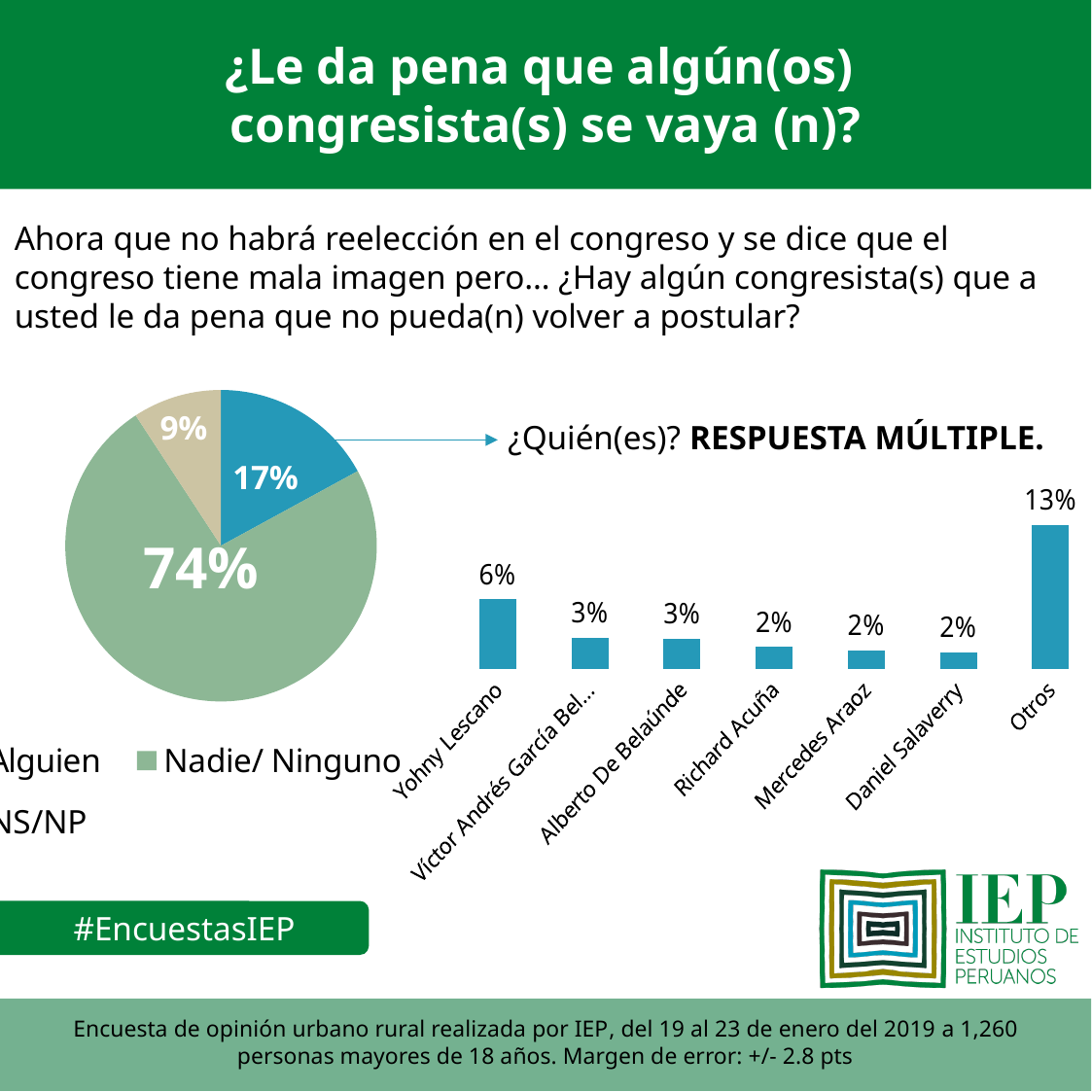
In the bar chart '¿Quién(es)? RESPUESTA MÚLTIPLE.', which category has the highest value? Otros What type of chart is the one on the right of the slide? Bar chart In the bar chart '¿Quién(es)? RESPUESTA MÚLTIPLE.', how many categories are shown? 7 In the pie chart on the left, what percentage is shown on the blue slice? 17% In the pie chart on the left, what share is labelled for the 'Nadie/ Ninguno' slice? 74% In the bar chart '¿Quién(es)? RESPUESTA MÚLTIPLE.', what is the value for Otros? 13% In the bar chart '¿Quién(es)? RESPUESTA MÚLTIPLE.', what is the value for Richard Acuña? 2% In the pie chart on the left, what percentage is shown on the smallest slice? 9% In the pie chart on the left, how many slices are there? 3 In the bar chart '¿Quién(es)? RESPUESTA MÚLTIPLE.', what is the difference between Otros and Yohny Lescano? 7% In the bar chart '¿Quién(es)? RESPUESTA MÚLTIPLE.', which is larger, Yohny Lescano or Alberto De Belaúnde? Yohny Lescano In the bar chart '¿Quién(es)? RESPUESTA MÚLTIPLE.', what is the value for Yohny Lescano? 6%